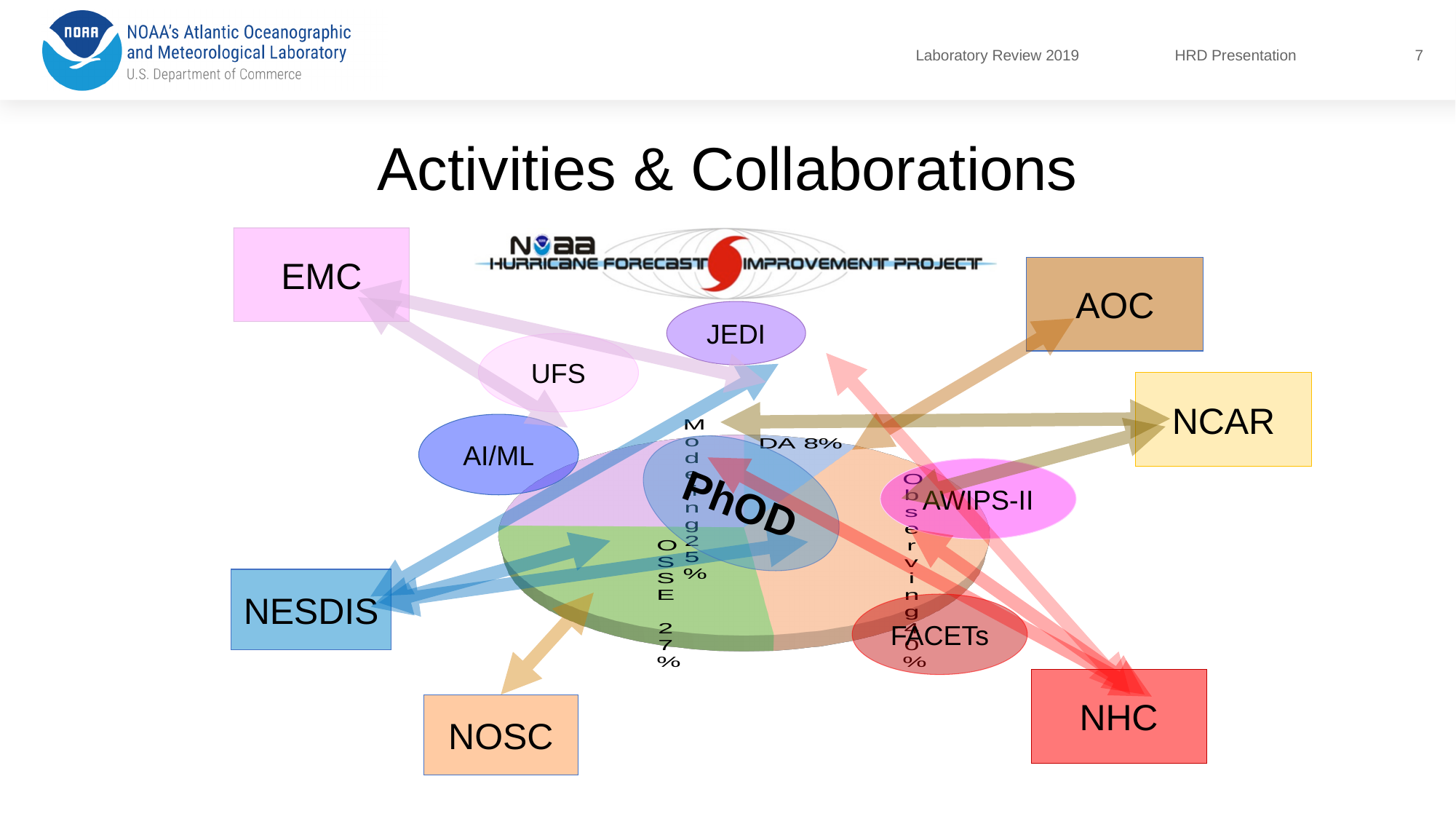
Which is larger in the pie chart, OSSE or Modeling? OSSE What colour is the OSSE slice of the pie chart? green What kind of chart is shown on the slide? pie chart What percentage does the Modeling slice of the pie chart represent? 25% Which slice of the pie chart is the largest? Observing What large text label is overlaid on the centre of the pie chart? PhOD How many slices does the pie chart have? 4 Which slice of the pie chart is the smallest? DA What percentage does the OSSE slice of the pie chart represent? 27% What percentage does the DA slice of the pie chart represent? 8% What is the difference in percentage points between the Modeling slice and the DA slice? 17 What is the difference in percentage points between the OSSE slice and the DA slice? 19